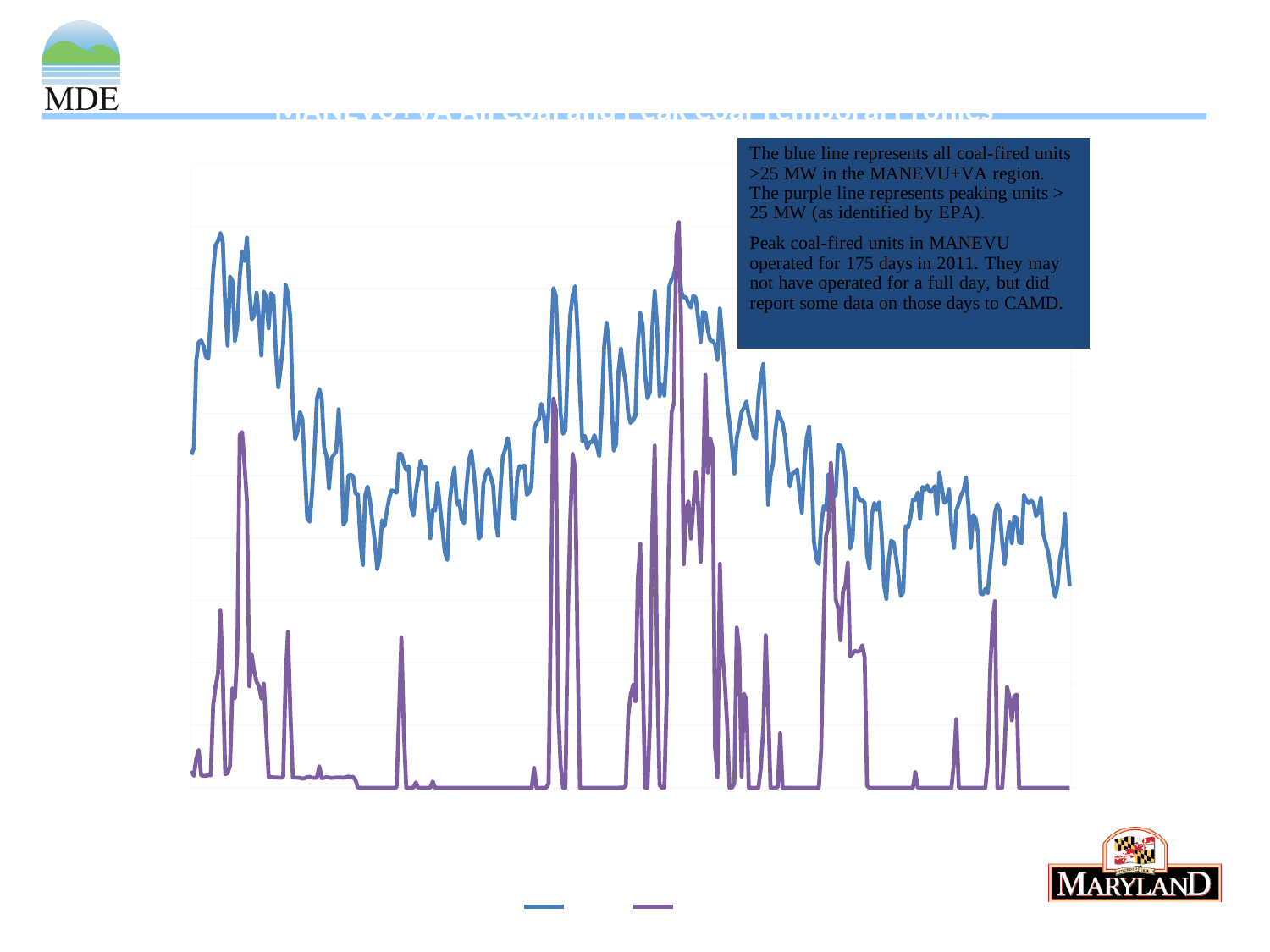
Which line stays flat along the bottom of the chart for long stretches, the blue line or the purple line? purple line Which line sits higher on the chart for most of the x axis, the blue line or the purple line? blue line According to the text box on the slide, what does the blue line represent? all coal-fired units >25 MW in the MANEVU+VA region What kind of chart is shown on the slide? line chart What colours are the two lines plotted on the chart? blue and purple How many series does the legend at the bottom of the chart show? 2